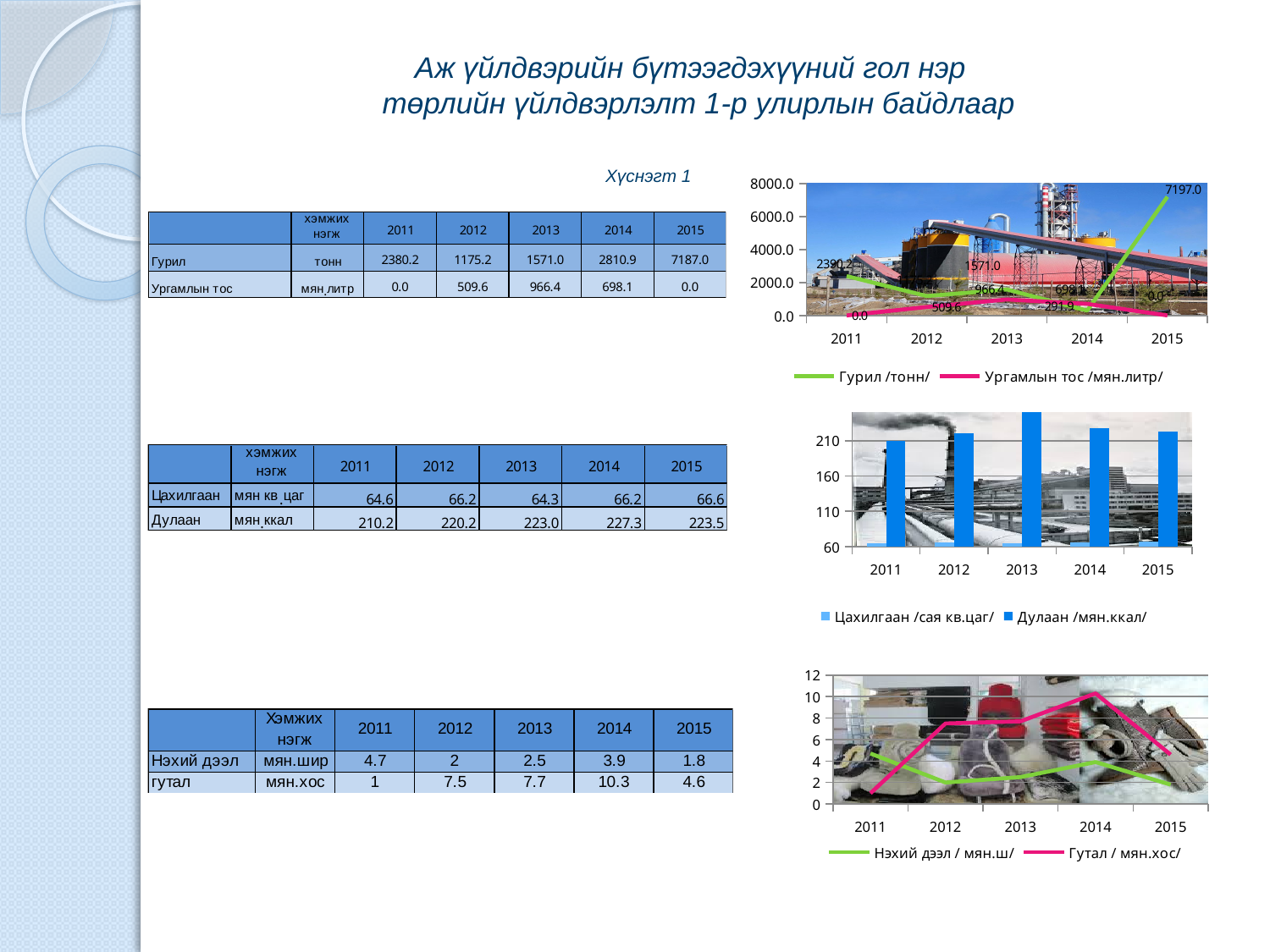
In the top chart (Гурил / Ургамлын тос), in which year is the Ургамлын тос value highest? 2013 In the bottom chart (Нэхий дээл / Гутал), in which year is the Гутал value highest? 2014 In the top chart (Гурил / Ургамлын тос), in which year is the Гурил value highest? 2015 In the middle chart (Цахилгаан / Дулаан), is the Дулаан value for 2011 greater or less than 160? greater In the bottom chart (Нэхий дээл / Гутал), is the Гутал value for 2014 greater or less than 8? greater In the top chart (Гурил / Ургамлын тос), what is the value for Ургамлын тос in 2012? 509.6 What kind of chart is the middle chart (Цахилгаан / Дулаан)? bar chart In the top chart (Гурил / Ургамлын тос), how many series does the legend list? 2 In the bottom chart (Нэхий дээл / Гутал), in which year is the Гутал value lowest? 2011 In the top chart (Гурил / Ургамлын тос), what is the value for Ургамлын тос in 2013? 966.4 In the middle chart (Цахилгаан / Дулаан), how many years are shown on the x axis? 5 In the bottom chart (Нэхий дээл / Гутал), which series has the larger value in 2014, Нэхий дээл or Гутал? Гутал